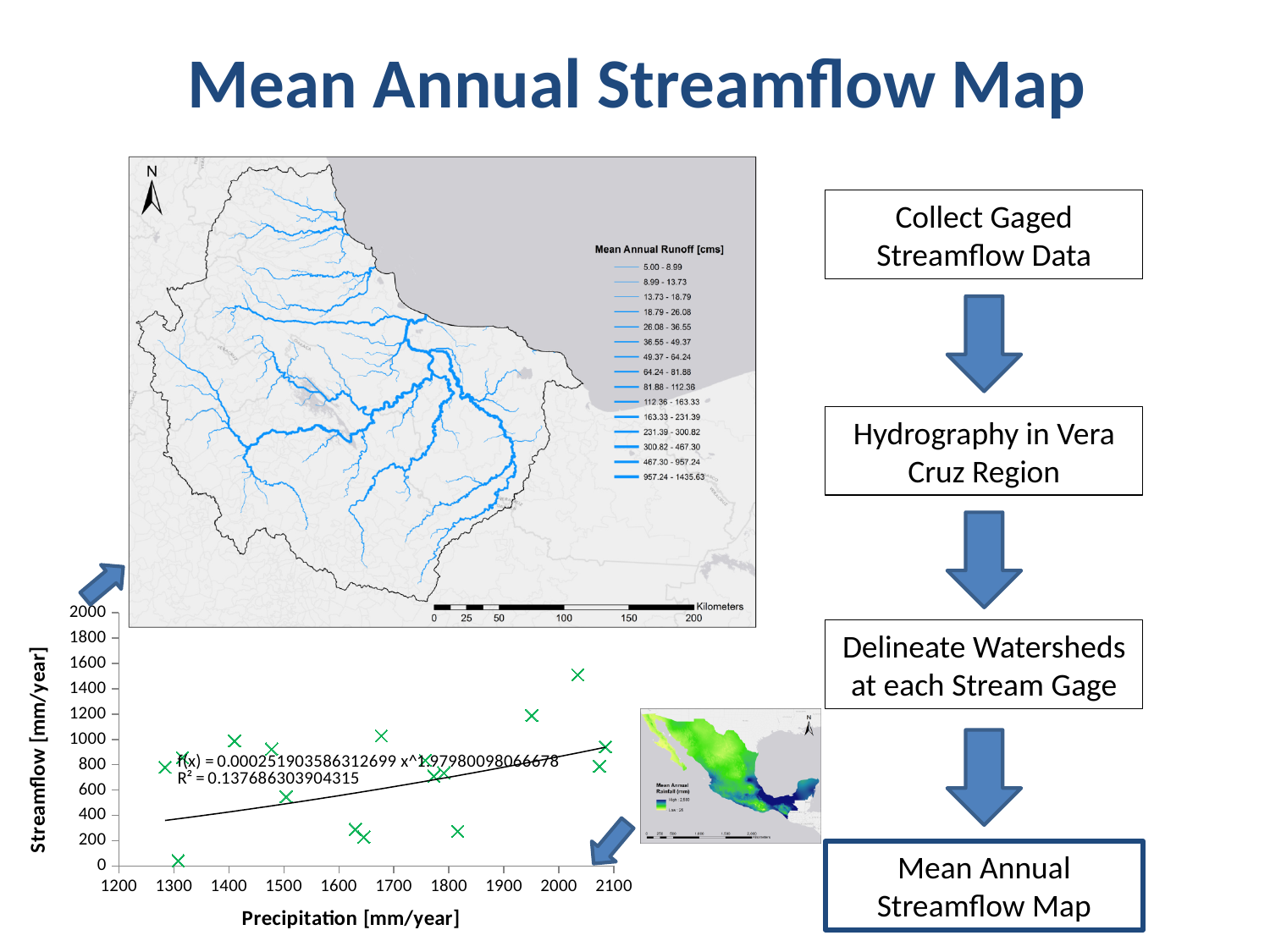
Is the streamflow of the highest point on the scatter chart greater or less than 1400? greater What is the maximum value shown on the y axis of the scatter chart? 2000 What R² value is printed on the scatter chart? 0.137686303904315 What is the exponent in the fitted equation f(x) shown on the scatter chart? 1.97980098066678 What is the coefficient in the fitted equation f(x) shown on the scatter chart? 0.000251903586312699 What is the label of the x axis of the scatter chart? Precipitation [mm/year] Is the streamflow of the lowest point on the scatter chart greater or less than 200? less Does the fitted trendline on the scatter chart rise or fall as precipitation increases? rise What is the label of the y axis of the scatter chart? Streamflow [mm/year] What kind of chart is shown at the bottom left of the slide? scatter chart